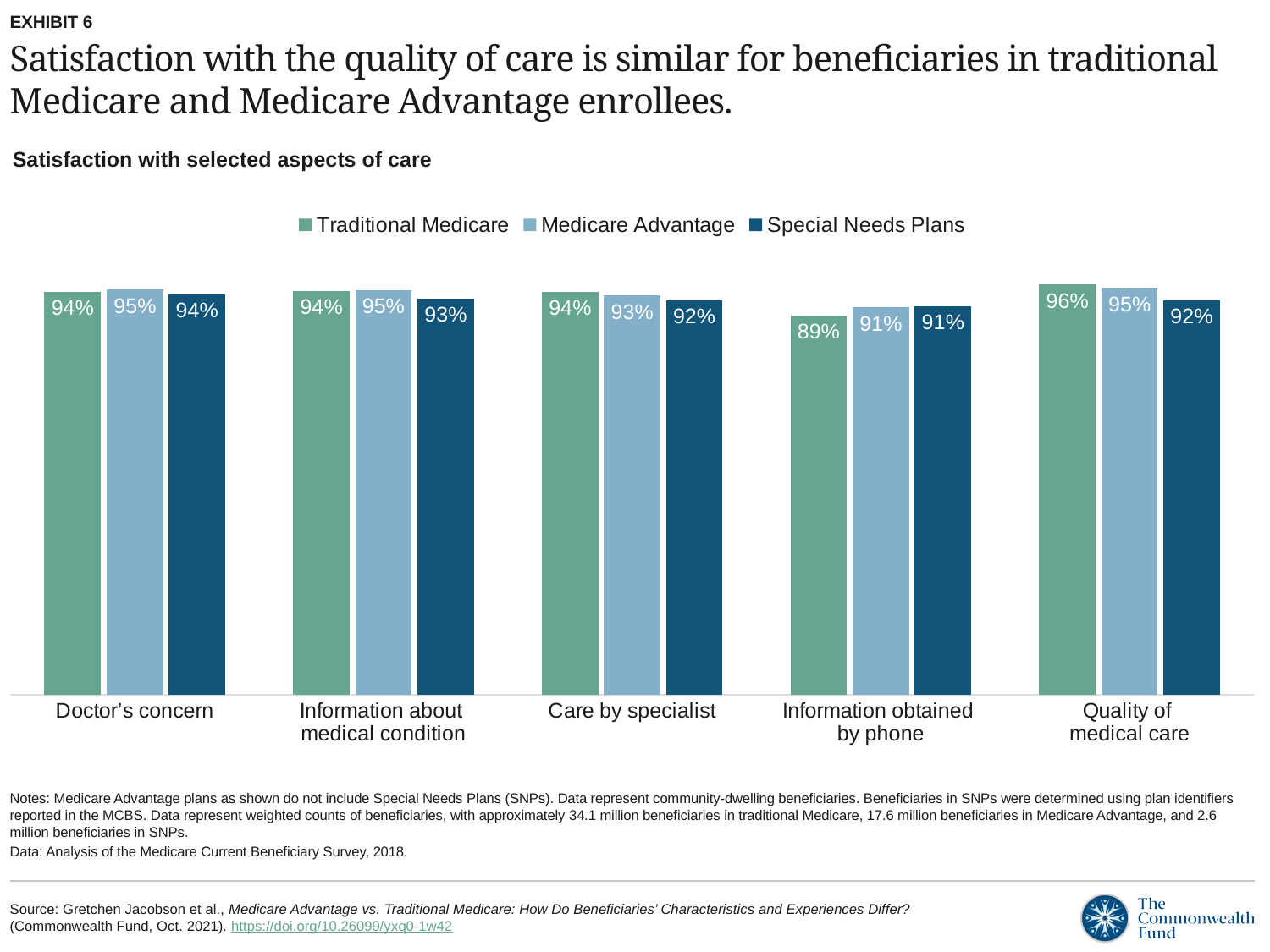
Which category has the highest Traditional Medicare value? Quality of medical care How many series does the legend list? 3 Which series is shown in the darkest blue? Special Needs Plans What is the Medicare Advantage value for Quality of medical care? 95% Which category has the lowest Traditional Medicare value? Information obtained by phone What kind of chart is shown? Bar chart How many categories are shown on the x axis? 5 What is the Traditional Medicare value for Information obtained by phone? 89% What is the Special Needs Plans value for Care by specialist? 92% What is the difference between the Traditional Medicare and Special Needs Plans values for Quality of medical care? 4% What is the chart's subtitle above the legend? Satisfaction with selected aspects of care For Information obtained by phone, which is larger: the Traditional Medicare value or the Medicare Advantage value? Medicare Advantage